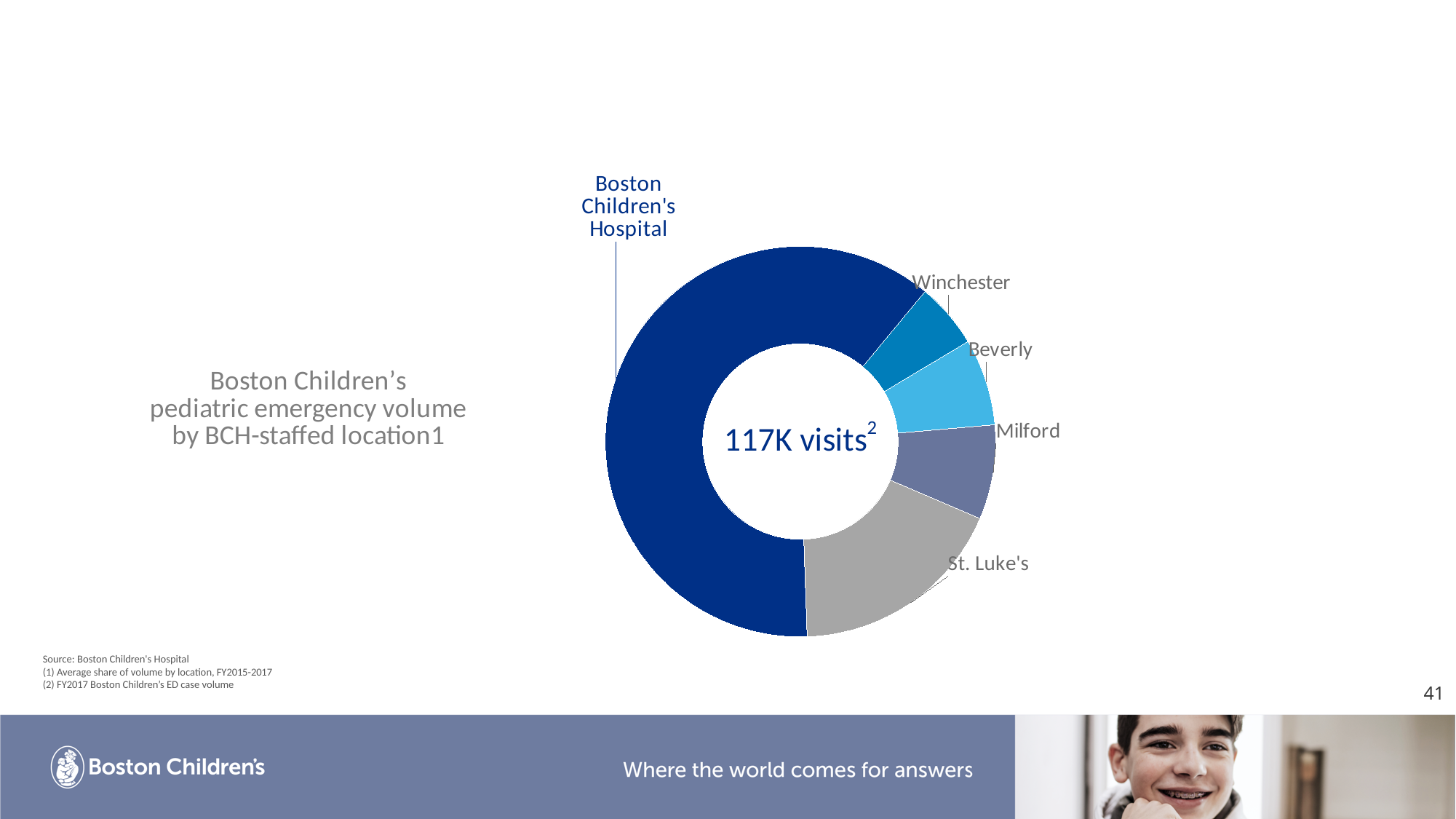
What total number of visits is printed in the center of the donut chart? 117K visits What is the title of the chart? Boston Children's pediatric emergency volume by BCH-staffed location Which has a larger share of volume, St. Luke's or Milford? St. Luke's Which has a larger share of volume, St. Luke's or Winchester? St. Luke's Which has a larger share of volume, Boston Children's Hospital or St. Luke's? Boston Children's Hospital Which location has the largest share of pediatric emergency volume? Boston Children's Hospital What colour is the slice for St. Luke's? Grey What kind of chart is shown on the slide? Pie chart (donut) How many locations are shown as slices in the chart? 5